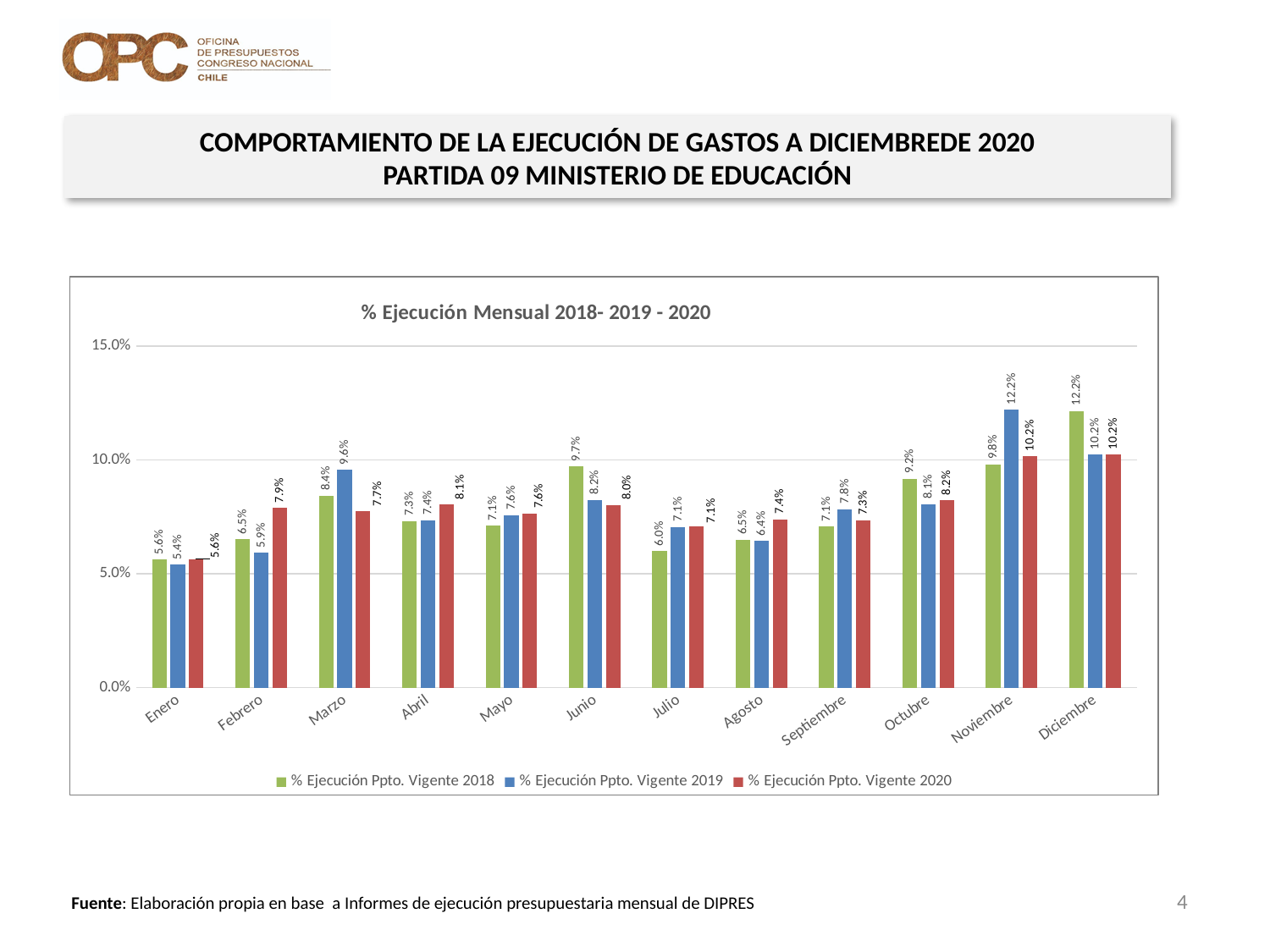
Which is larger in Octubre: the % Ejecución Ppto. Vigente 2018 value or the 2019 value? % Ejecución Ppto. Vigente 2018 How many series does the legend list? 3 What is the value for % Ejecución Ppto. Vigente 2018 in Junio? 9.7% What is the value for % Ejecución Ppto. Vigente 2020 in Febrero? 7.9% Is the value for % Ejecución Ppto. Vigente 2018 in Diciembre greater or less than 10.0%? greater What is the difference between the % Ejecución Ppto. Vigente 2019 and 2018 values in Noviembre? 2.4% What kind of chart is shown on the slide? Bar chart In which month is the % Ejecución Ppto. Vigente 2018 value lowest? Enero What is the title of the chart? % Ejecución Mensual 2018- 2019 - 2020 In which month is the % Ejecución Ppto. Vigente 2019 value highest? Noviembre How many months are shown on the x axis? 12 What is the value for % Ejecución Ppto. Vigente 2019 in Marzo? 9.6%